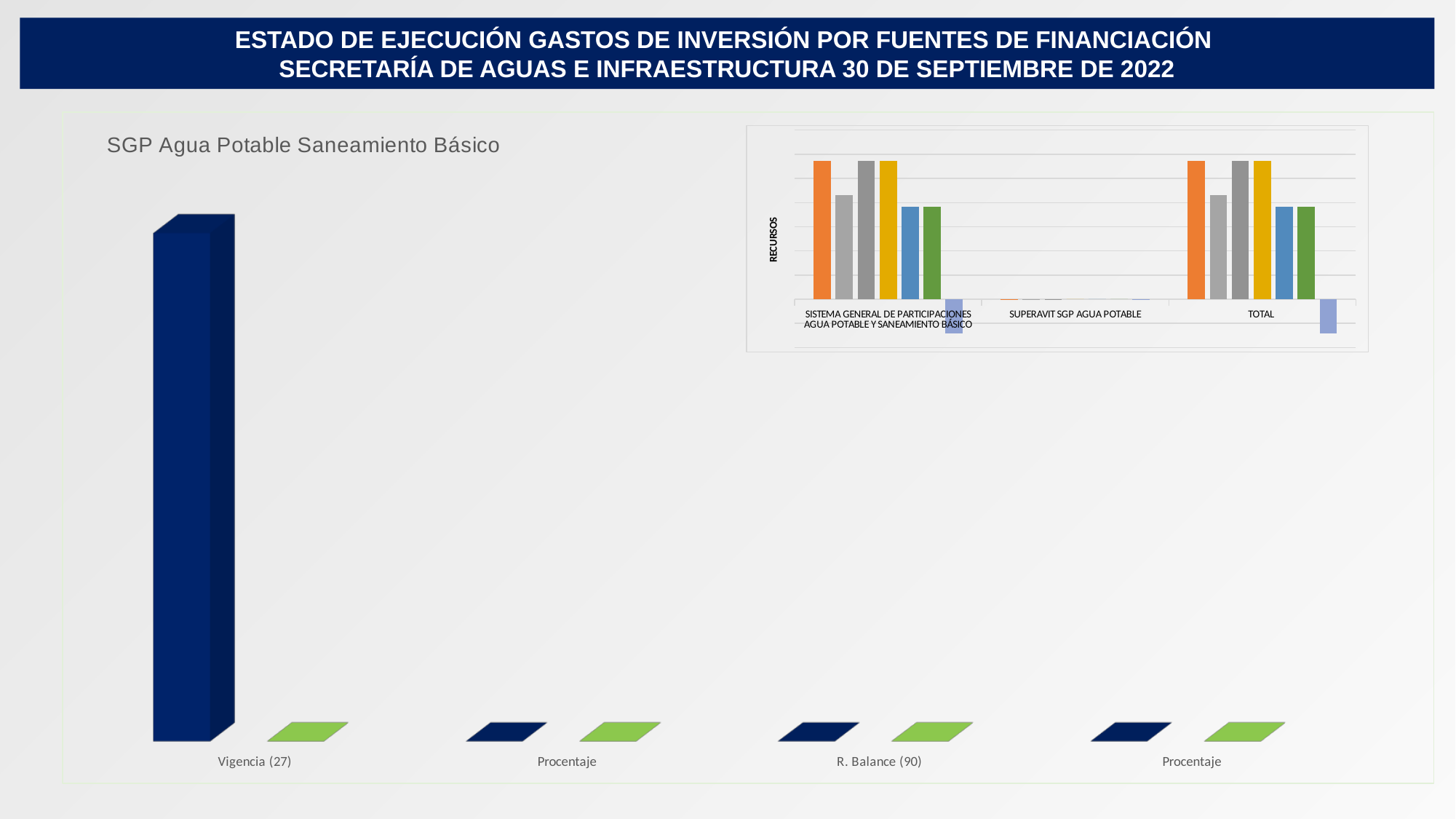
What is the title of the chart on the left side of the slide? SGP Agua Potable Saneamiento Básico What kind of chart is the chart on the left titled 'SGP Agua Potable Saneamiento Básico'? bar chart In the chart on the right side of the slide, which is larger, the orange bar for TOTAL or the orange bar for SUPERAVIT SGP AGUA POTABLE? TOTAL What kind of chart is the chart on the right side of the slide? bar chart What is the label of the vertical axis of the chart on the right side of the slide? RECURSOS In the chart on the right side of the slide, which is taller for the TOTAL category, the orange bar or the green bar? the orange bar How many categories are shown on the x axis of the chart on the right side of the slide? 3 In the left chart 'SGP Agua Potable Saneamiento Básico', which is larger, the dark blue bar for Vigencia (27) or the dark blue bar for R. Balance (90)? Vigencia (27) In the left chart 'SGP Agua Potable Saneamiento Básico', which category has the tallest bar? Vigencia (27) How many categories are shown on the x axis of the left chart 'SGP Agua Potable Saneamiento Básico'? 4 What is the label of the first category on the x axis of the left chart 'SGP Agua Potable Saneamiento Básico'? Vigencia (27) In the chart on the right side of the slide, which category has the lowest bars? SUPERAVIT SGP AGUA POTABLE